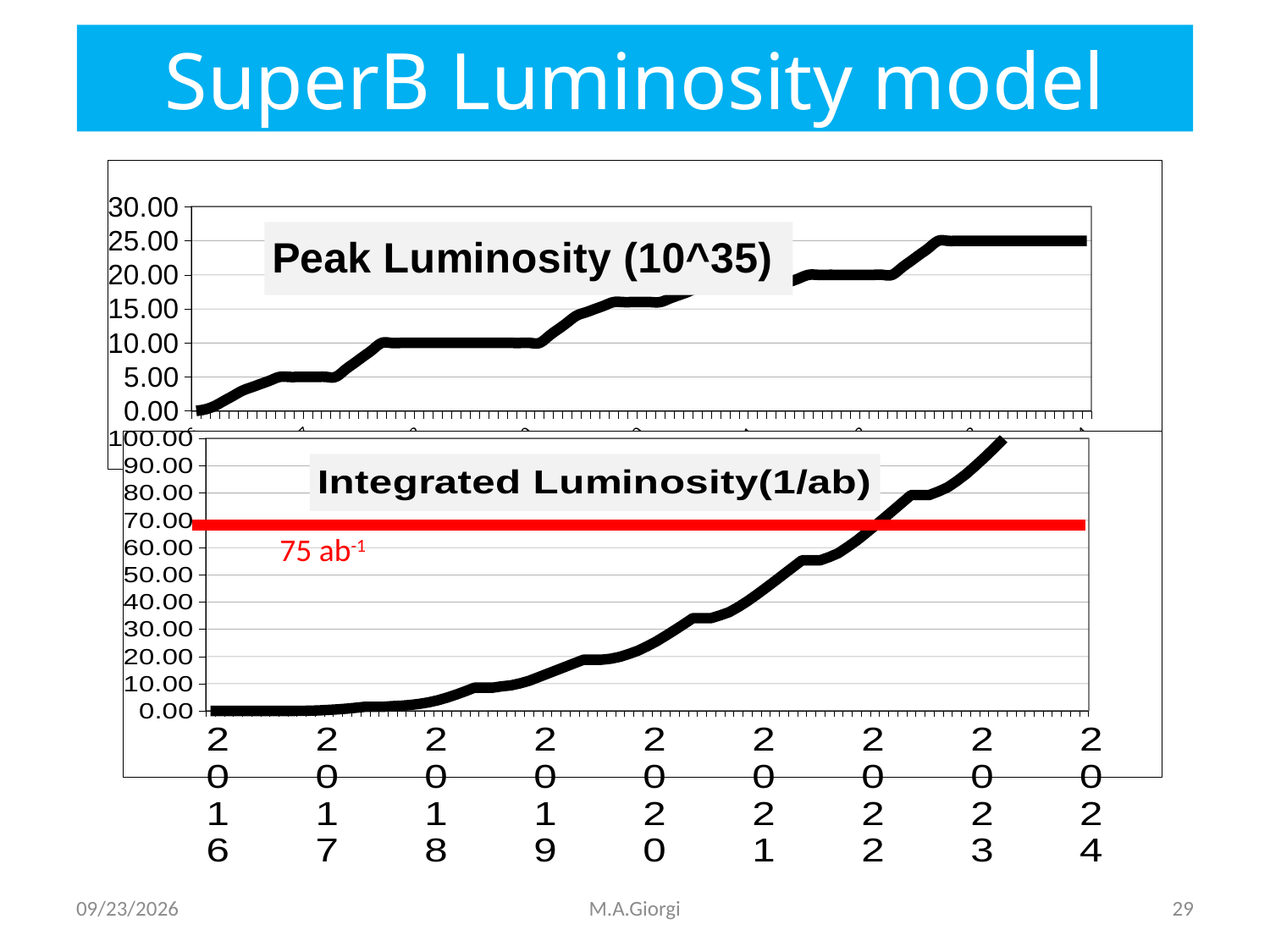
In the Integrated Luminosity(1/ab) chart, is the value at 2020 greater or less than 40? less In the Peak Luminosity (10^35) chart, is the value at 2020 greater or less than 10? greater How many year labels are shown on the x axis of the Integrated Luminosity(1/ab) chart? 9 In the Integrated Luminosity(1/ab) chart, what label is written next to the red horizontal line? 75 ab-1 In the Peak Luminosity (10^35) chart, is the value at 2016 greater or less than 5? less In the Integrated Luminosity(1/ab) chart, do the values rise or fall along the x axis? rise What kind of chart is the Integrated Luminosity(1/ab) chart? line chart What kind of chart is the Peak Luminosity (10^35) chart? line chart In the Peak Luminosity (10^35) chart, do the values rise or fall from 2016 to 2024? rise